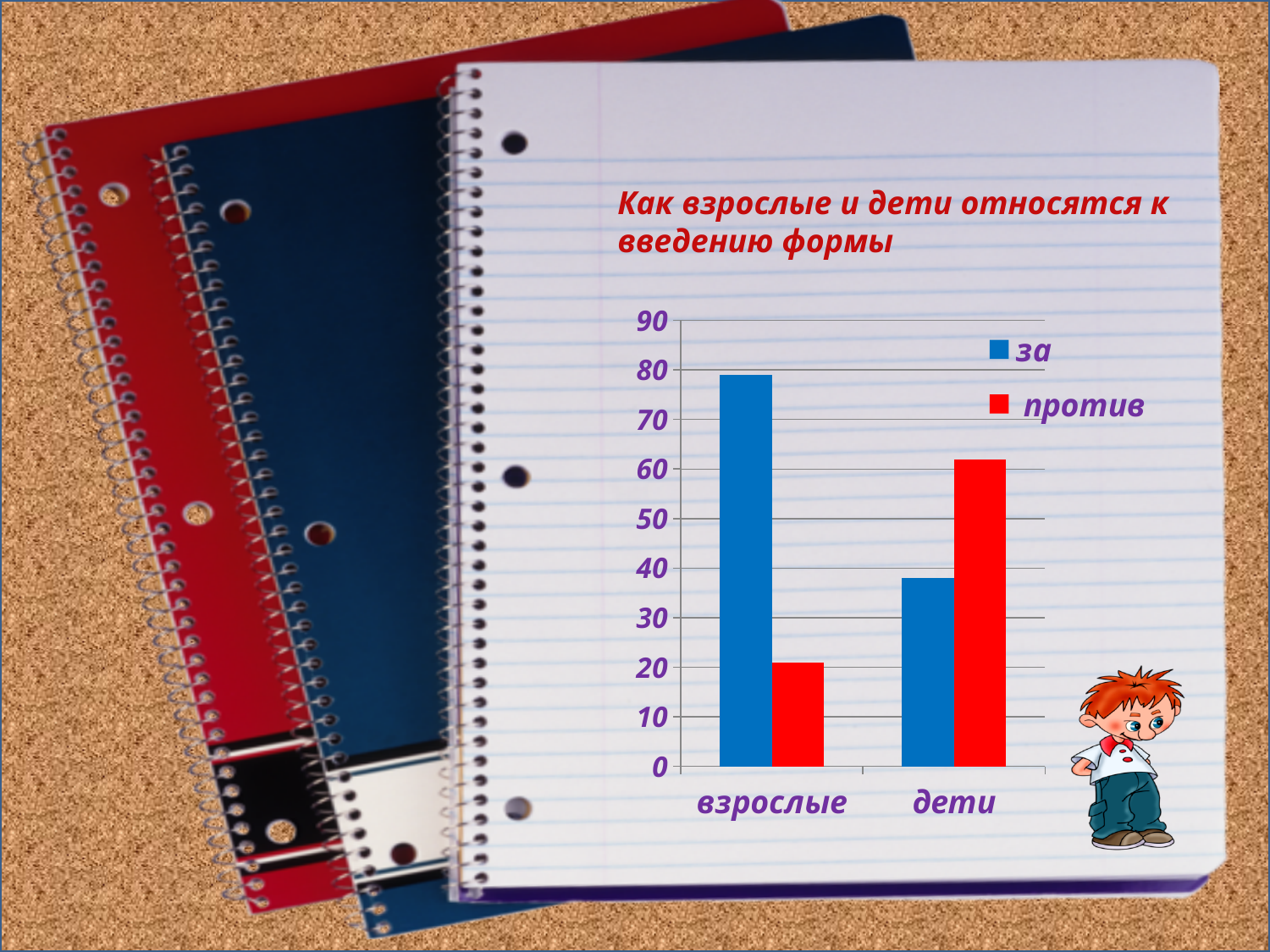
How many categories are shown on the x axis? 2 What is the title of the chart? Как взрослые и дети относятся к введению формы Is the value for 'против' in the 'дети' category greater or less than 50? greater Which category has the higher value for 'за': взрослые or дети? взрослые Which category has the higher value for 'против': взрослые or дети? дети Which bar is the tallest in the chart? за for взрослые Is the value for 'за' in the 'дети' category greater or less than 50? less How many series does the legend list? 2 Is the value for 'против' in the 'взрослые' category greater or less than 30? less What kind of chart is shown on the slide? bar chart Which series is shown in red in the legend? против